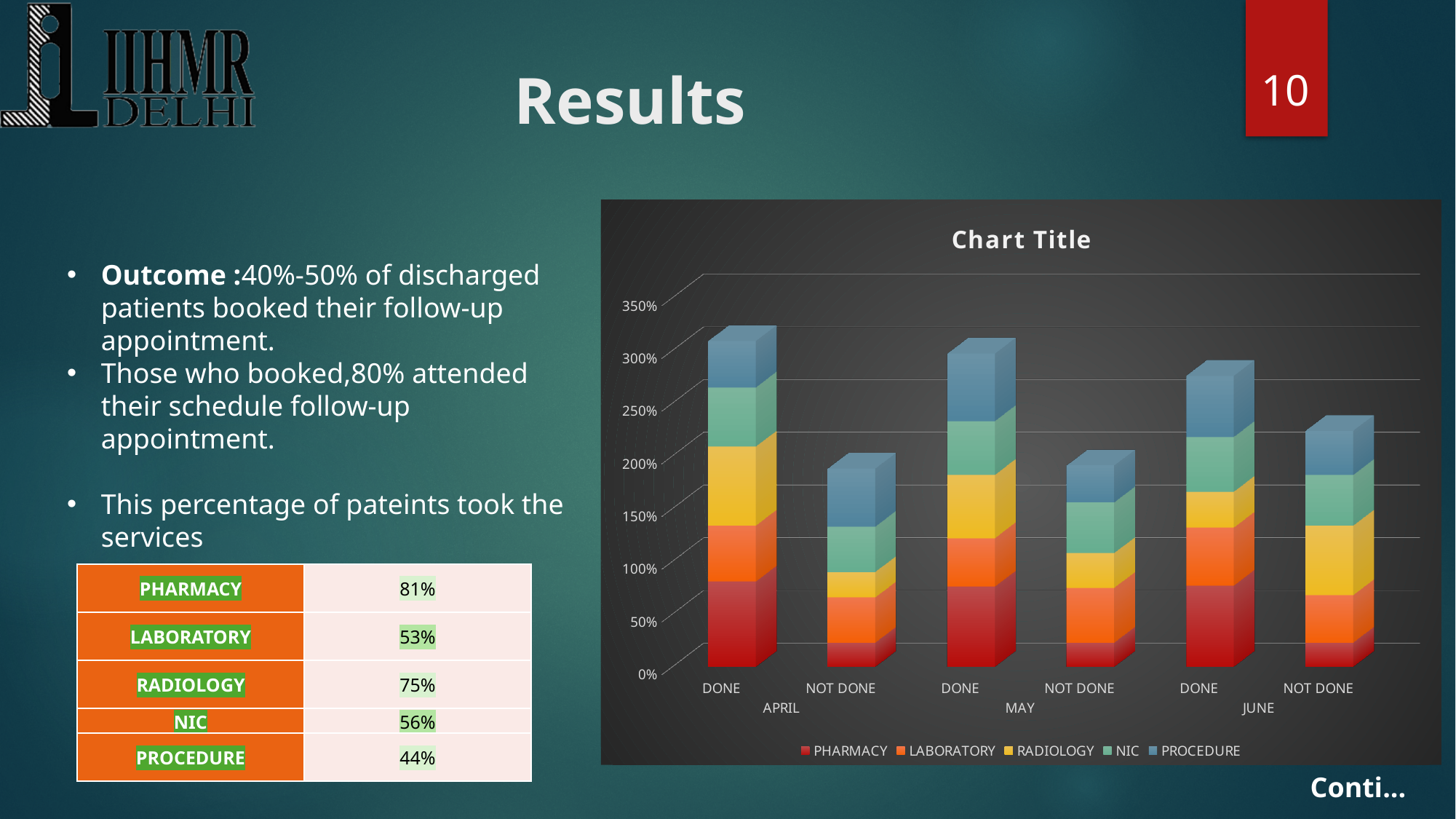
Which bar is taller, MAY DONE or MAY NOT DONE? MAY DONE Which series is listed first in the chart's legend? PHARMACY Is the total of the JUNE DONE bar greater or less than 300%? less How many bars are plotted in the chart? 6 How many series does the chart's legend list? 5 Is the total of the APRIL DONE bar greater or less than 250%? greater Which bar is taller, APRIL DONE or APRIL NOT DONE? APRIL DONE Is the total of the JUNE NOT DONE bar greater or less than 200%? greater Which bar is taller, JUNE DONE or JUNE NOT DONE? JUNE DONE What kind of chart is shown on the slide? Stacked bar chart What is the title of the chart? Chart Title